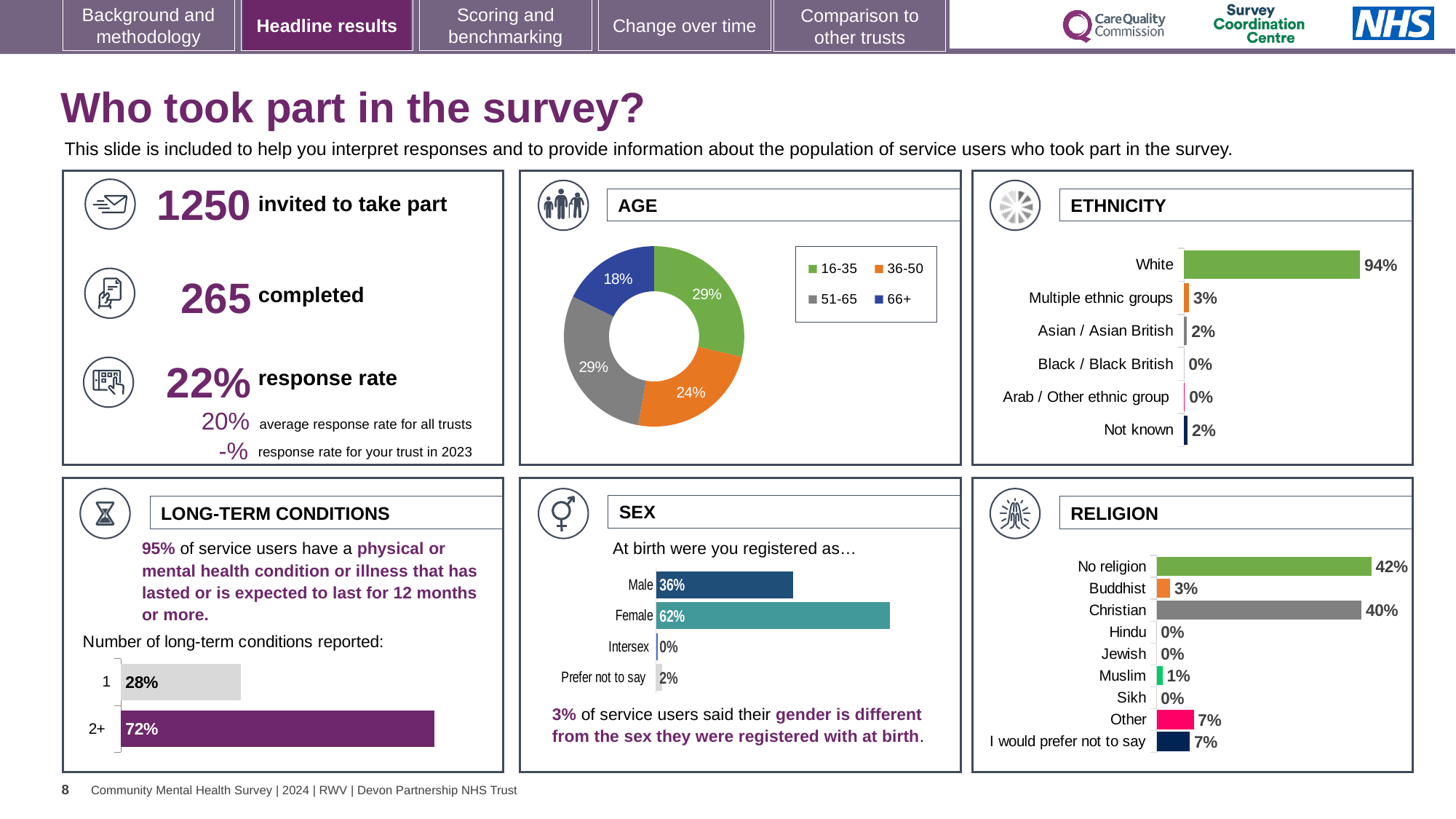
What kind of chart is the RELIGION chart? Bar chart In the RELIGION chart, what is the value for Christian? 40% In the SEX chart, which is larger, Male or Female? Female How many categories are shown in the ETHNICITY chart? 6 In the ETHNICITY chart, which category has the highest value? White In the SEX chart, what is the difference between the Female and Male values? 26% In the ETHNICITY chart, what is the value for White? 94% In the AGE chart, what share of respondents are aged 66+? 18% In the LONG-TERM CONDITIONS chart, what percentage reported 2+ conditions? 72% How many age groups does the legend of the AGE chart list? 4 What kind of chart is the AGE chart? Doughnut chart In the RELIGION chart, which category has the highest value? No religion